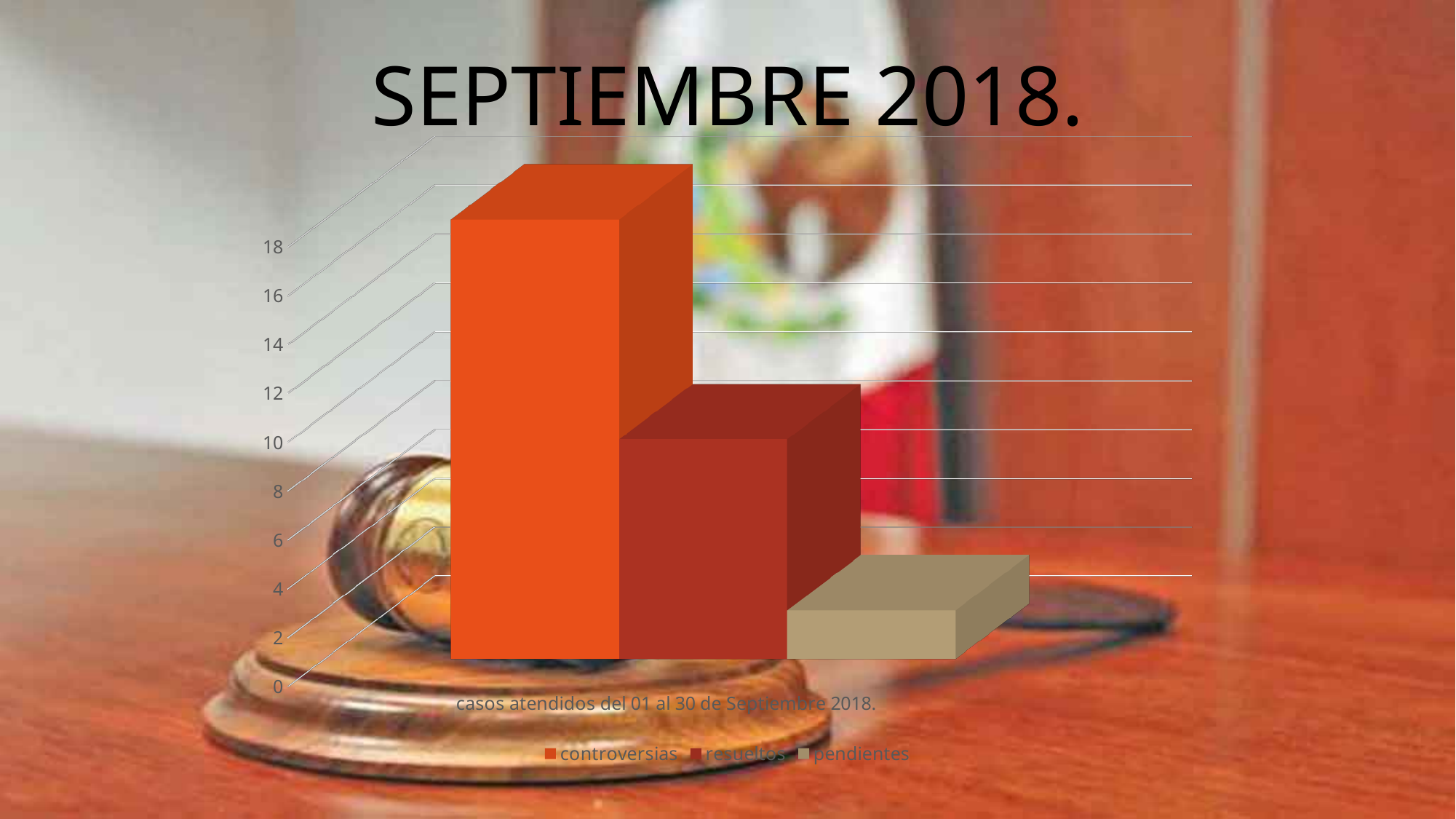
Which is larger, the value for resueltos or the value for pendientes? resueltos Which is larger, the value for controversias or the value for resueltos? controversias Which series has the lowest bar? pendientes Is the value for controversias greater or less than 10? greater Is the value for pendientes greater or less than 6? less How many series does the legend list? 3 What kind of chart is shown on the slide? bar chart What are the three legend entries of the chart? controversias, resueltos, pendientes Is the value for resueltos greater or less than 14? less Which series has the highest bar? controversias How many bars are plotted in the chart? 3